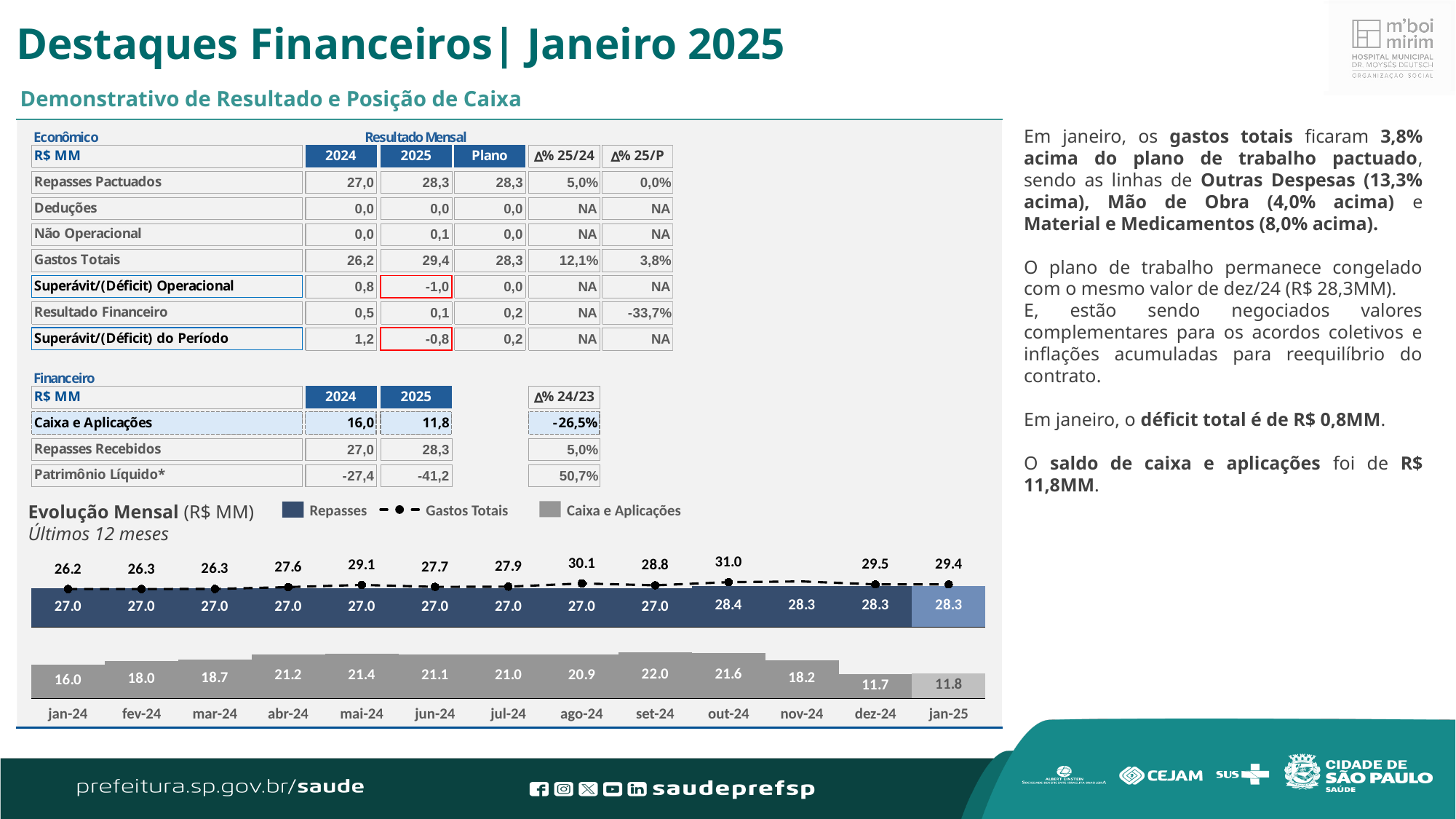
In the Evolução Mensal chart, what is the Repasses value for jan-24? 27.0 How many series does the legend of the Evolução Mensal chart list? 3 In the Evolução Mensal chart, is the Caixa e Aplicações value larger in abr-24 or in nov-24? abr-24 In the Evolução Mensal chart, what is the difference between the Caixa e Aplicações values for set-24 and dez-24? 10.3 In the Evolução Mensal chart, what is the Caixa e Aplicações value for jan-25? 11.8 In the Evolução Mensal chart, what is the difference between the Gastos Totais and Repasses values for jan-25? 1.1 In the Evolução Mensal chart, which month has the lowest Caixa e Aplicações value? dez-24 In the Evolução Mensal chart, what is the Gastos Totais value for out-24? 31.0 In the Evolução Mensal chart, which month has the highest labelled Gastos Totais value? out-24 In the Evolução Mensal chart, which series is drawn as a dashed line with dots? Gastos Totais How many months are shown on the x axis of the Evolução Mensal chart? 13 In the Evolução Mensal chart, which month has the highest Caixa e Aplicações value? set-24